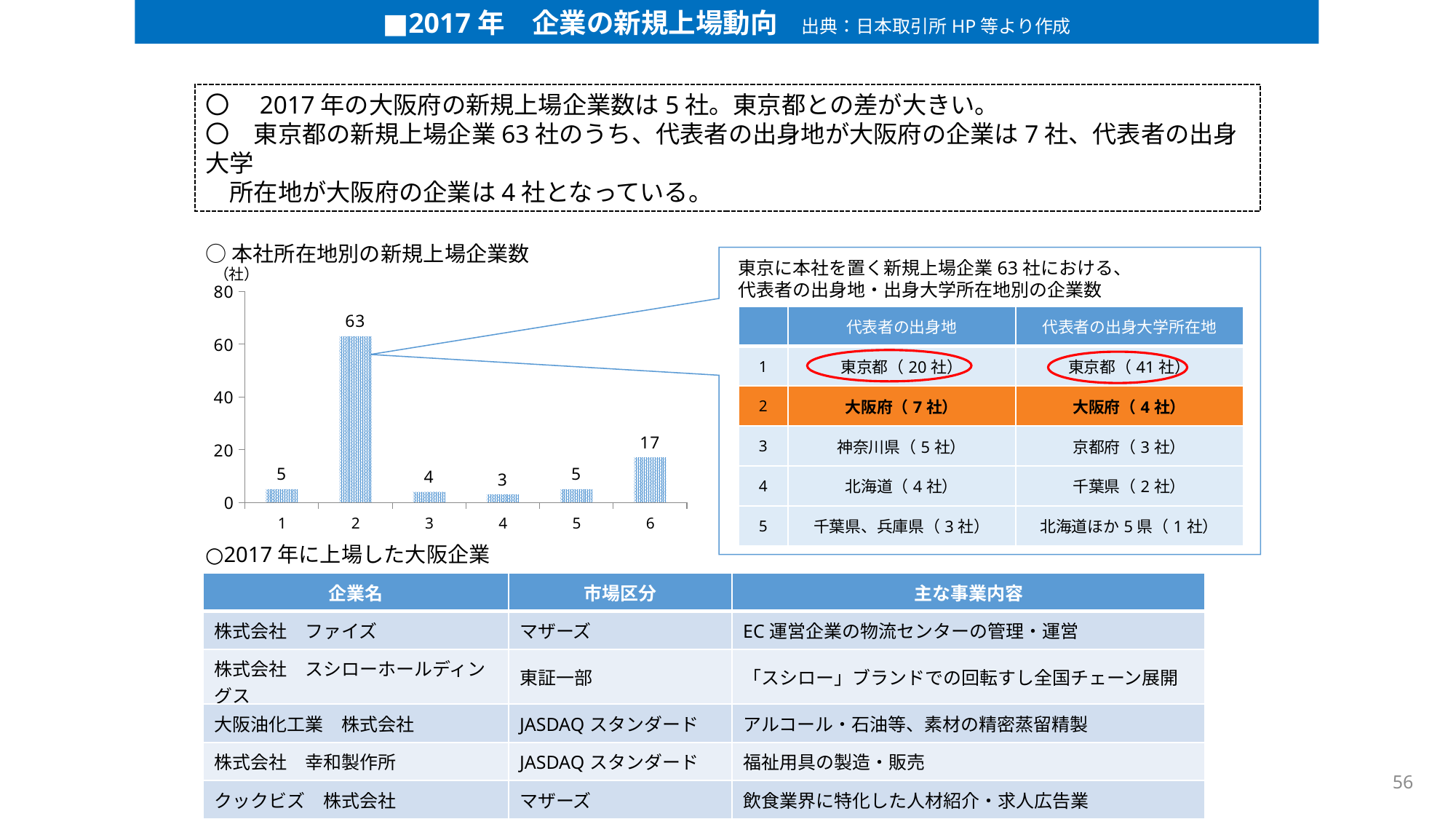
Which category has the lowest value in the bar chart 本社所在地別の新規上場企業数? 4 What unit is shown on the y axis of the bar chart 本社所在地別の新規上場企業数? 社 What kind of chart is 本社所在地別の新規上場企業数? bar chart In the bar chart 本社所在地別の新規上場企業数, which is larger, the value for category 6 or the value for category 5? category 6 In the bar chart 本社所在地別の新規上場企業数, what is the difference between the values for category 1 and category 3? 1 How many categories are shown in the bar chart 本社所在地別の新規上場企業数? 6 What is the value for category 2 in the bar chart 本社所在地別の新規上場企業数? 63 In the bar chart 本社所在地別の新規上場企業数, what is the difference between the values for category 2 and category 6? 46 What is the value for category 1 in the bar chart 本社所在地別の新規上場企業数? 5 What is the value for category 6 in the bar chart 本社所在地別の新規上場企業数? 17 Which category has the highest value in the bar chart 本社所在地別の新規上場企業数? 2 What is the value for category 4 in the bar chart 本社所在地別の新規上場企業数? 3